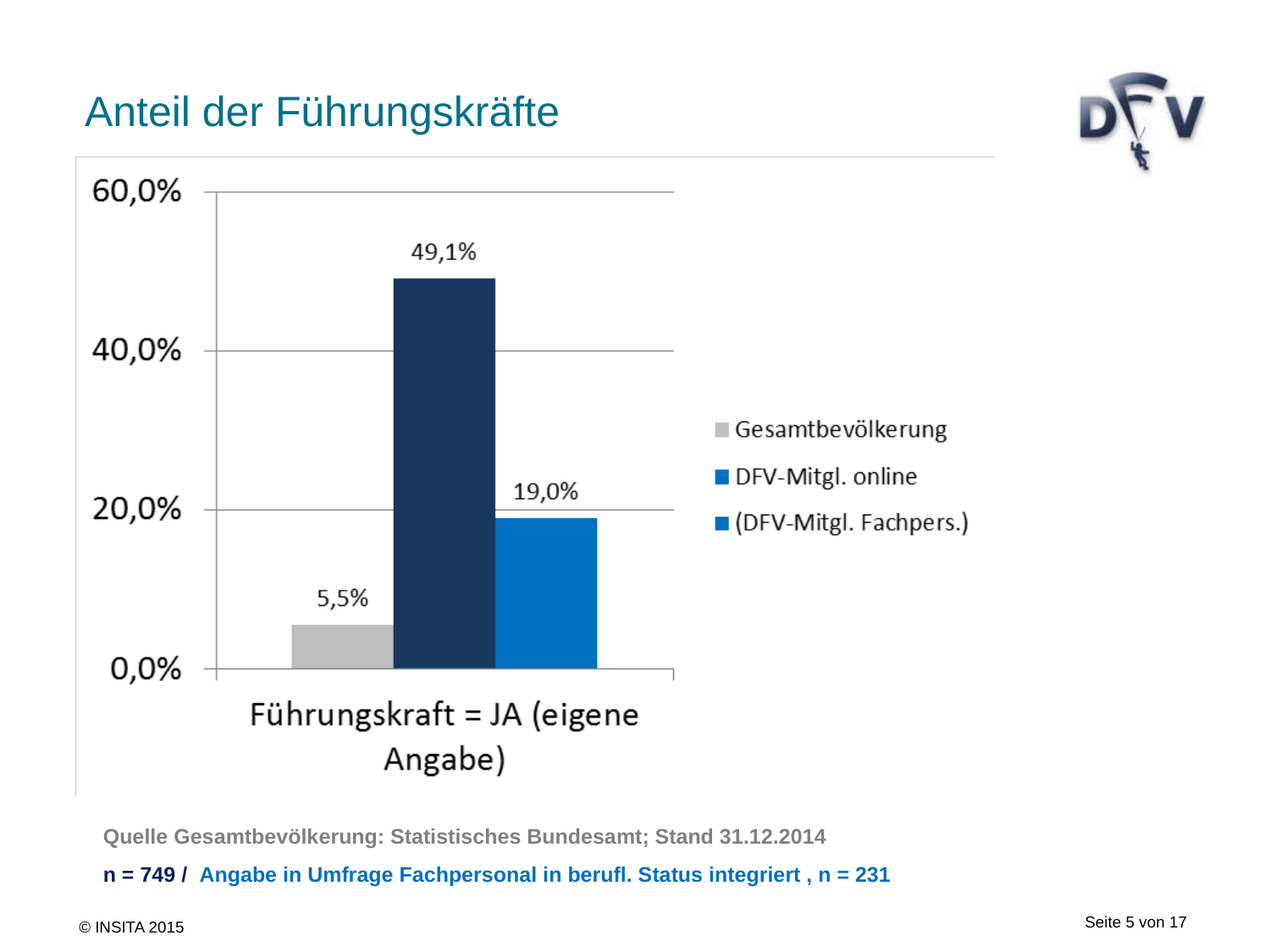
What is the difference between the values for DFV-Mitgl. online and (DFV-Mitgl. Fachpers.)? 30,1% Which series has the highest value? DFV-Mitgl. online What kind of chart is shown on the slide? bar chart What is the value for (DFV-Mitgl. Fachpers.)? 19,0% Which is larger, the value for Gesamtbevölkerung or the value for (DFV-Mitgl. Fachpers.)? (DFV-Mitgl. Fachpers.) What is the value for DFV-Mitgl. online? 49,1% What is the difference between the values for (DFV-Mitgl. Fachpers.) and Gesamtbevölkerung? 13,5% What is the category label on the x axis? Führungskraft = JA (eigene Angabe) How many series does the legend list? 3 Is the value for DFV-Mitgl. online greater or less than 40,0%? greater Which series has the lowest value? Gesamtbevölkerung What is the value for Gesamtbevölkerung? 5,5%